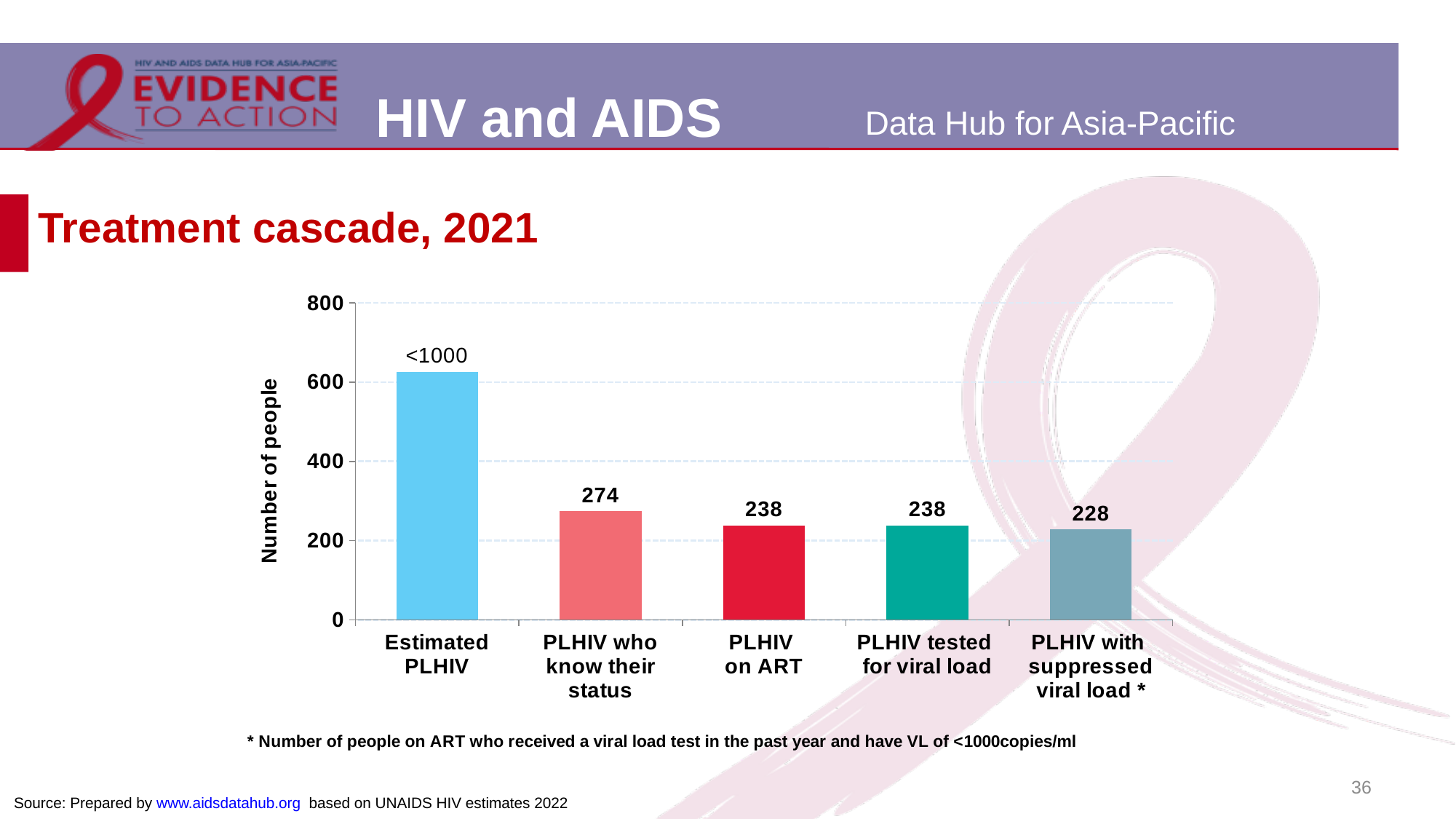
What is the value for PLHIV who know their status? 274 What is the value for PLHIV with suppressed viral load? 228 What is the value for PLHIV on ART? 238 Is the bar for Estimated PLHIV greater or less than 600? greater Which category has the highest bar? Estimated PLHIV Which is larger: PLHIV who know their status or PLHIV on ART? PLHIV who know their status What kind of chart is shown on the slide? bar chart What data label is shown above the Estimated PLHIV bar? <1000 How many categories are shown on the x axis? 5 What is the difference between PLHIV who know their status and PLHIV on ART? 36 Which category has the lowest value? PLHIV with suppressed viral load What is the difference between PLHIV tested for viral load and PLHIV with suppressed viral load? 10